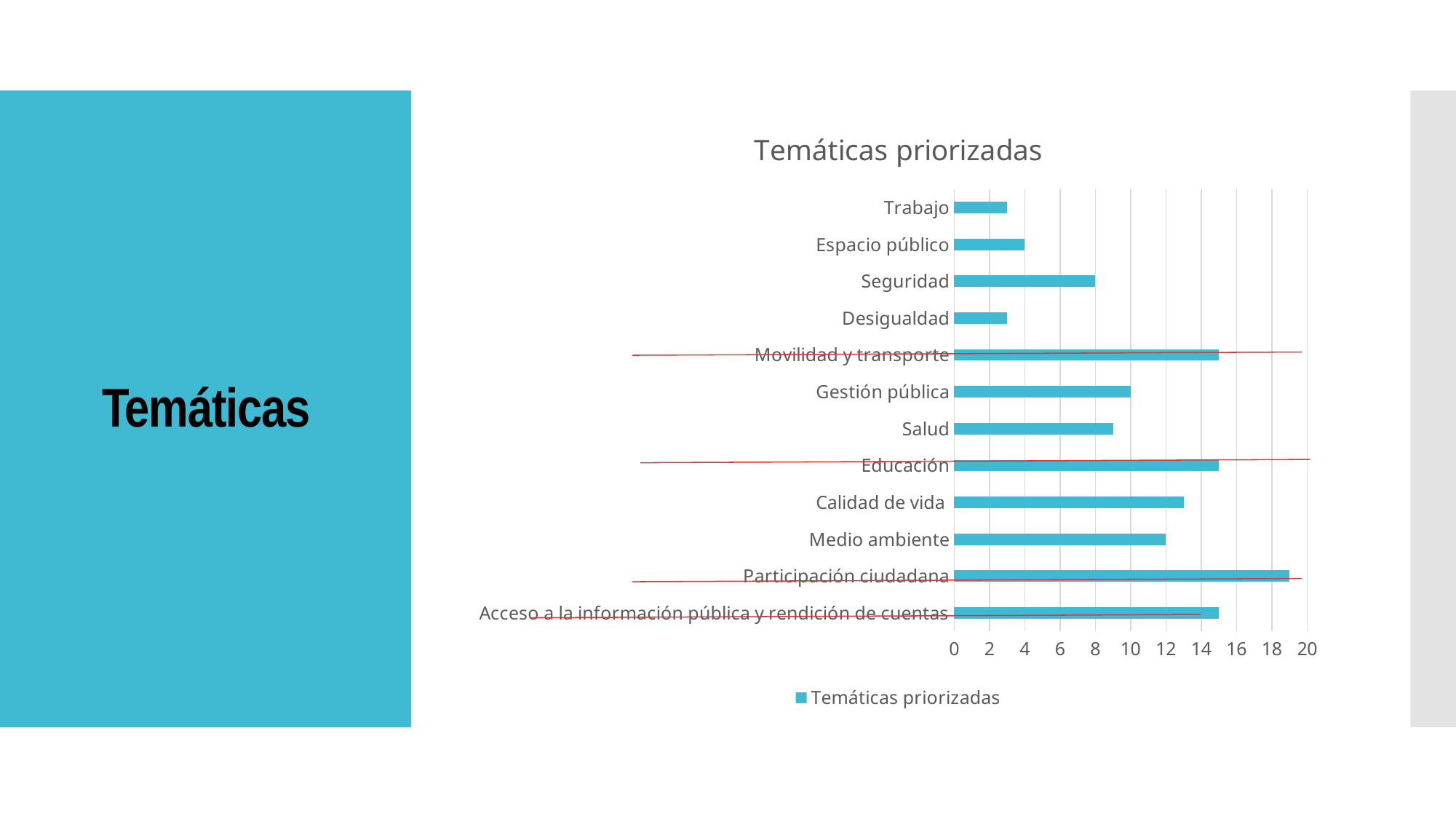
Which category has the highest value in the chart? Participación ciudadana How many categories are plotted in the chart? 12 What is the value for Medio ambiente? 12 What is the title of the chart? Temáticas priorizadas Is the value for Calidad de vida greater or less than 14? less Is the value for Trabajo greater or less than 4? less What kind of chart is shown on the slide? Bar chart How many series does the legend list? 1 Is the value for Participación ciudadana greater or less than 18? greater What is the value for Seguridad? 8 What is the value for Gestión pública? 10 Which is larger, the value for Calidad de vida or the value for Salud? Calidad de vida